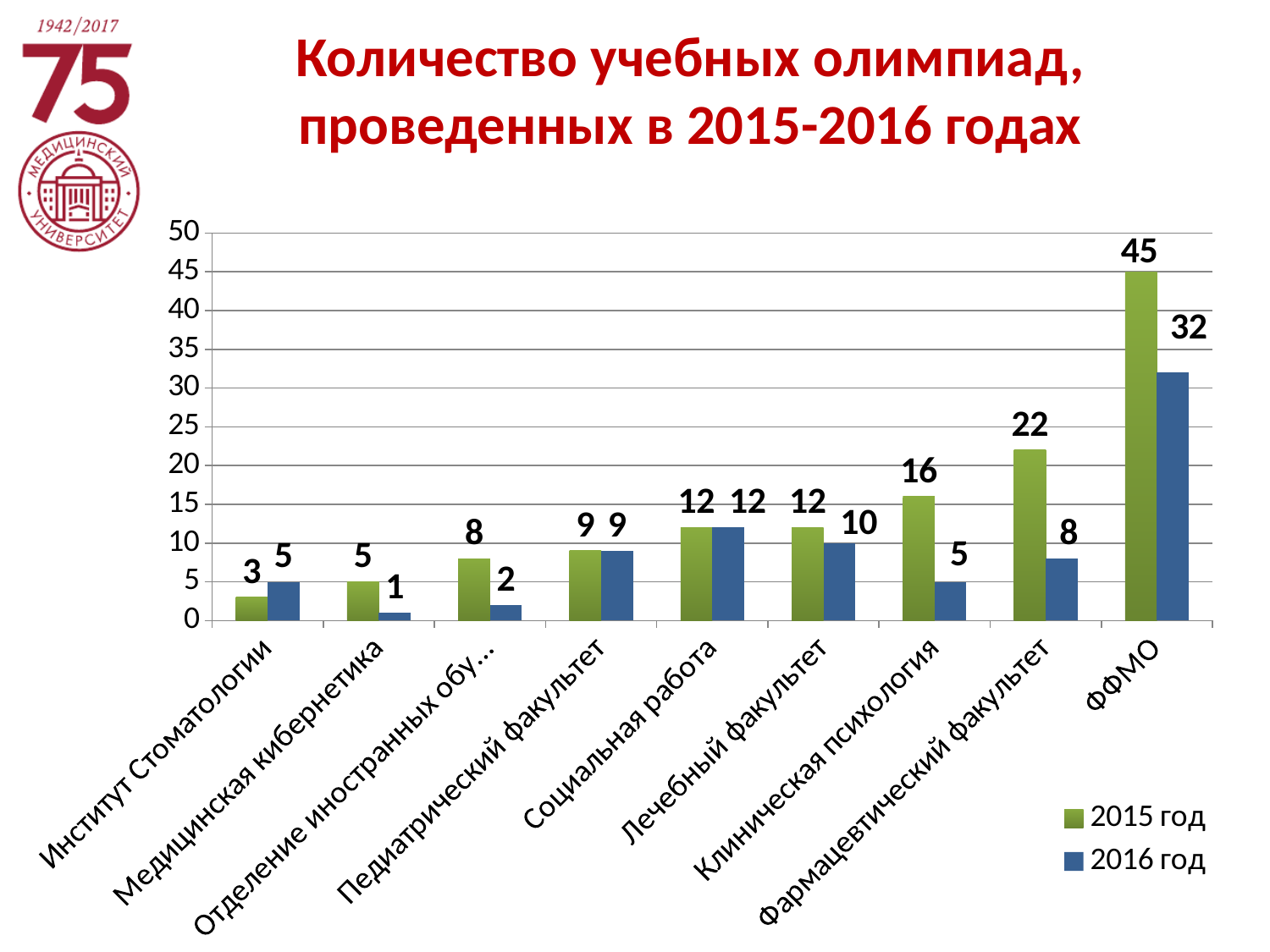
Which category has the lowest value in the 2016 год series? Медицинская кибернетика Which category has the lowest value in the 2015 год series? Институт Стоматологии What is the value for ФФМО in the 2015 год series? 45 What is the value for Клиническая психология in the 2015 год series? 16 What kind of chart is shown on the slide? bar chart Which is larger for Институт Стоматологии: the 2015 год value or the 2016 год value? 2016 год What is the value for Лечебный факультет in the 2016 год series? 10 Which category has the highest value in the 2016 год series? ФФМО What is the difference between the 2015 год and 2016 год values for Фармацевтический факультет? 14 What is the title of the chart on the slide? Количество учебных олимпиад, проведенных в 2015-2016 годах How many series does the legend list? 2 How many categories are shown on the x axis? 9